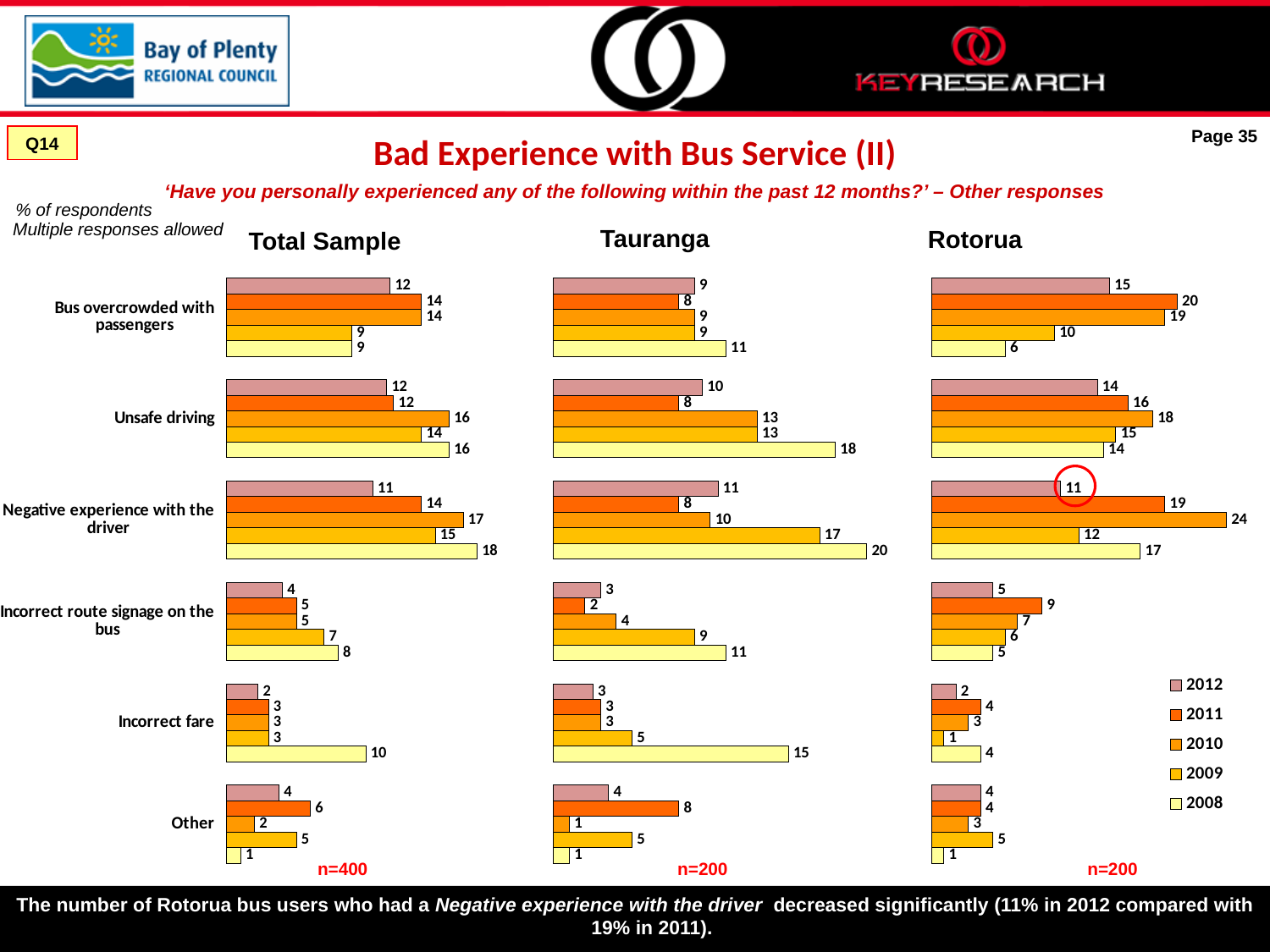
How many series does the legend list? 5 How many categories are shown in the Total Sample chart? 6 In the Rotorua chart, which year has the highest value for Negative experience with the driver? 2010 In the Tauranga chart, which is larger for Unsafe driving: the 2008 value or the 2012 value? 2008 What kind of chart is used for the Tauranga data? Bar chart In the Total Sample chart, what is the 2008 value for Incorrect fare? 10 In the Tauranga chart, which year has the lowest value for Incorrect route signage on the bus? 2011 In the Tauranga chart, what is the 2008 value for Negative experience with the driver? 20 In the Rotorua chart, what is the 2011 value for Bus overcrowded with passengers? 20 What is the sample size (n) shown for the Total Sample chart? n=400 In the Rotorua chart, what is the 2012 value for Negative experience with the driver? 11 In the Rotorua chart, what is the difference between the 2011 and 2012 values for Negative experience with the driver? 8